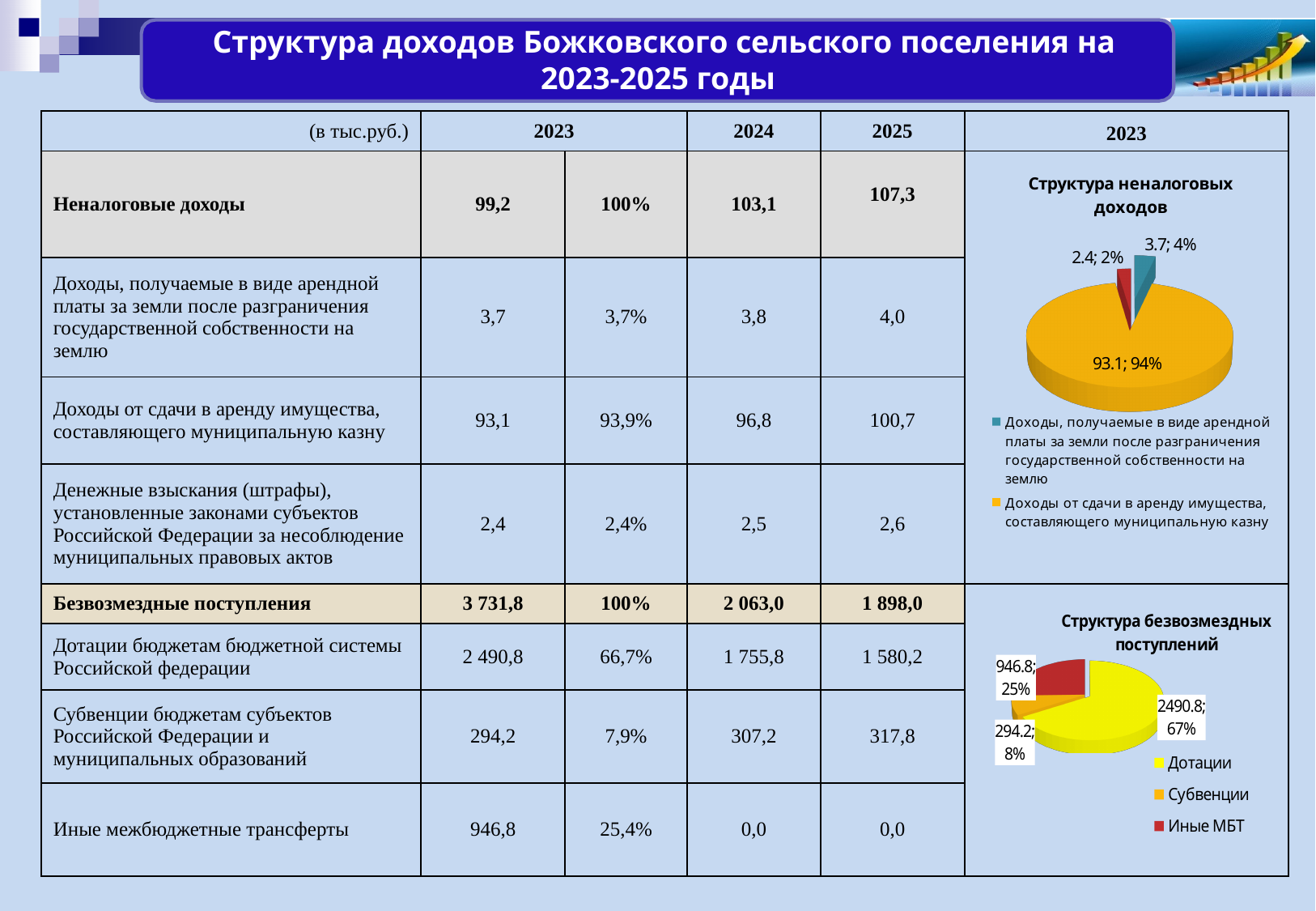
In the chart "Структура безвозмездных поступлений", which category has the largest slice? Дотации What kind of chart is the chart titled "Структура безвозмездных поступлений"? pie chart In the chart "Структура неналоговых доходов", how many slices does the pie have? 3 What kind of chart is the chart titled "Структура неналоговых доходов"? pie chart In the chart "Структура безвозмездных поступлений", what share of the pie does Дотации have? 67% In the chart "Структура неналоговых доходов", how many entries does the legend list? 2 In the chart "Структура безвозмездных поступлений", which category has the smallest slice? Субвенции In the chart "Структура безвозмездных поступлений", what value is shown for Субвенции? 294.2 In the chart "Структура безвозмездных поступлений", what share of the pie does Иные МБТ have? 25% In the chart "Структура неналоговых доходов", what value is shown for "Доходы, получаемые в виде арендной платы за земли после разграничения государственной собственности на землю"? 3.7 In the chart "Структура неналоговых доходов", what share of the pie does "Доходы от сдачи в аренду имущества, составляющего муниципальную казну" have? 94% In the chart "Структура безвозмездных поступлений", how many entries does the legend list? 3